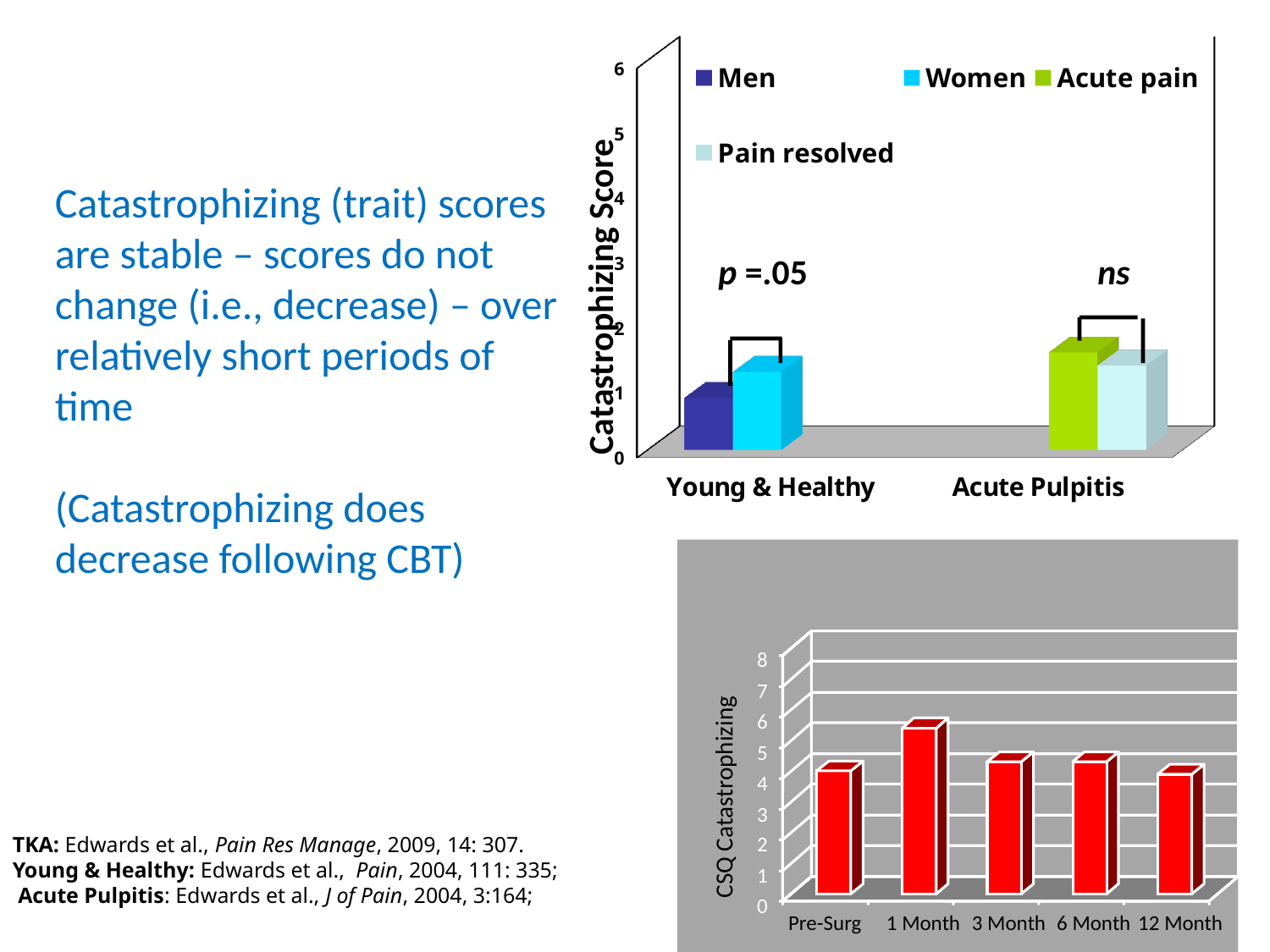
In the bottom chart, is the value for 1 Month greater or less than 5? greater In the top chart, which of the two bars for Young & Healthy is taller, Men or Women? Women In the top chart, how many categories are shown on the x axis? 2 In the top chart, is the value for Acute pain (Acute Pulpitis) greater or less than 1? greater In the bottom chart, which is larger, the value for 1 Month or the value for 3 Month? 1 Month In the top chart, is the value for Men (Young & Healthy) greater or less than 2? less What kind of chart is the bottom chart? bar chart In the bottom chart, how many time points are plotted? 5 In the bottom chart, which time point has the highest CSQ Catastrophizing value? 1 Month In the top chart, how many series does the legend list? 4 What is the y-axis title of the top chart? Catastrophizing Score